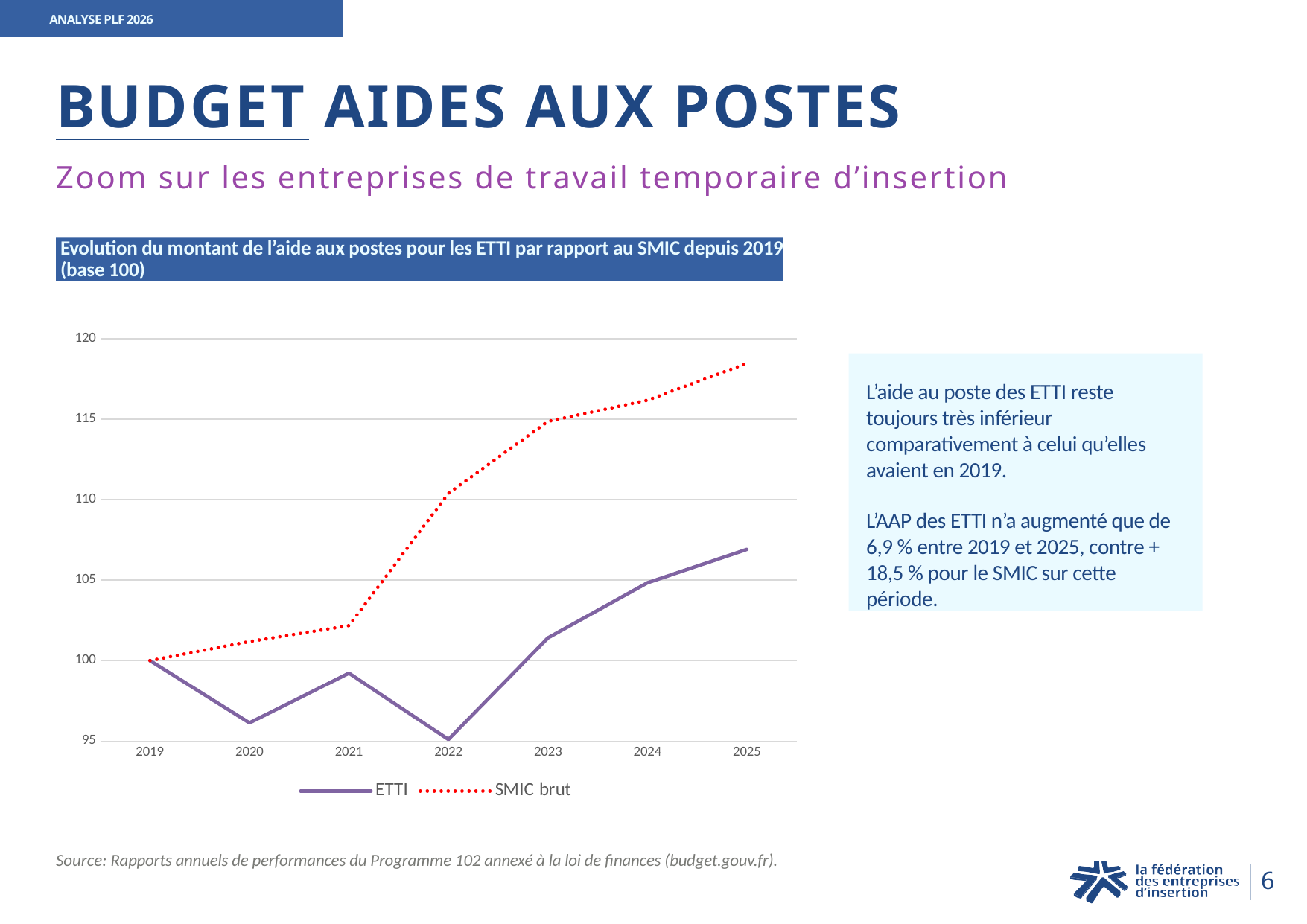
Does the SMIC brut series rise or fall from 2019 to 2025? rise In which year is the SMIC brut series at its highest? 2025 Is the value for ETTI in 2025 greater or less than 105? greater What kind of chart is shown on the slide? line chart Is the value for ETTI in 2020 greater or less than 100? less Is the value for SMIC brut in 2025 greater or less than 115? greater How many years are plotted along the x axis of the chart? 7 How many series does the chart legend list? 2 In which year is the ETTI series at its lowest? 2022 What is the value of the SMIC brut series in 2019? 100 What is the value of the ETTI series in 2019? 100 In 2025, which series has the higher value, ETTI or SMIC brut? SMIC brut